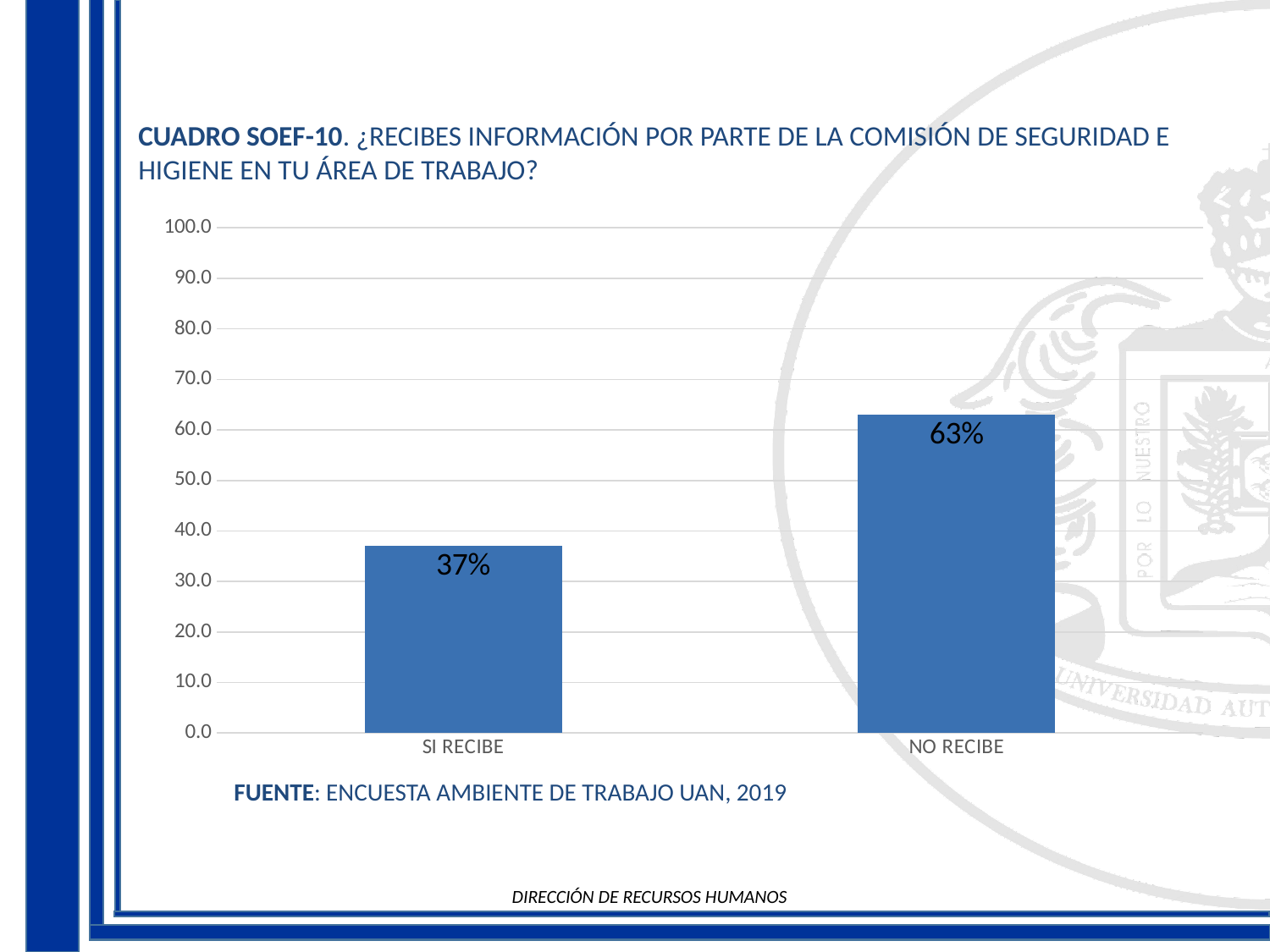
Is the value for NO RECIBE greater or less than 50.0? greater Is the value for SI RECIBE greater or less than 40.0? less What is the difference between the values for NO RECIBE and SI RECIBE? 26% How many categories are shown on the x axis? 2 Which category has the lowest value? SI RECIBE Which category has the highest value? NO RECIBE What is the value for NO RECIBE? 63% What is the source cited below the chart? ENCUESTA AMBIENTE DE TRABAJO UAN, 2019 What is the highest value shown on the y axis? 100.0 What kind of chart is shown on the slide? bar chart Which is larger, the value for SI RECIBE or the value for NO RECIBE? NO RECIBE What is the value for SI RECIBE? 37%